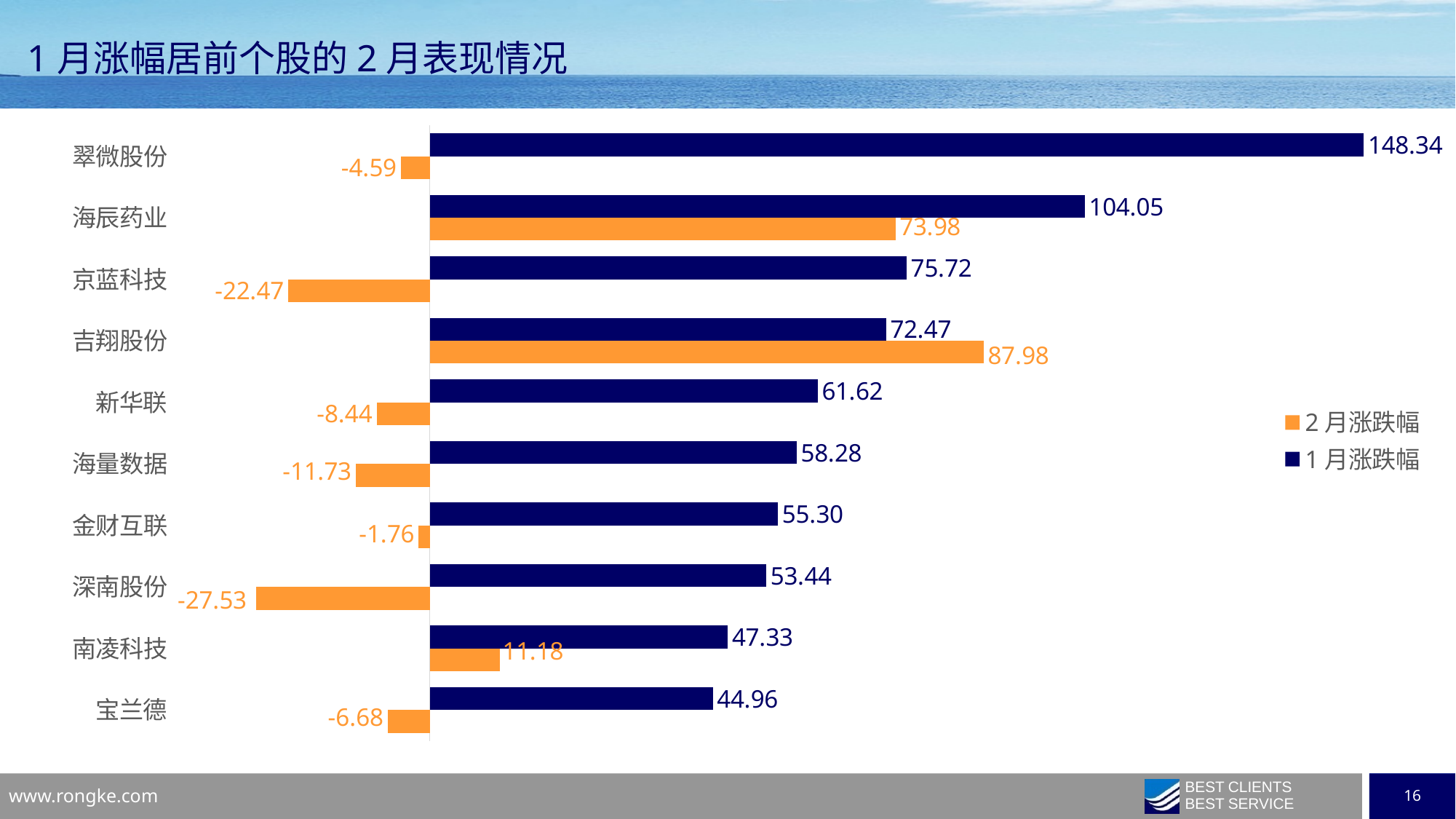
What is the 2月涨跌幅 value for 吉翔股份? 87.98 Which stock has the highest 1月涨跌幅? 翠微股份 How many series does the legend list? 2 What is the difference between the 1月涨跌幅 and 2月涨跌幅 values for 海辰药业? 30.07 What is the 2月涨跌幅 value for 深南股份? -27.53 What kind of chart is shown on the slide? Bar chart Which is larger for 吉翔股份: the 1月涨跌幅 or the 2月涨跌幅? 2月涨跌幅 How many stocks are shown in the chart? 10 What is the 1月涨跌幅 value for 宝兰德? 44.96 Which colour represents 2月涨跌幅 in the chart? Orange Which stock has the lowest 2月涨跌幅? 深南股份 What is the 1月涨跌幅 value for 翠微股份? 148.34